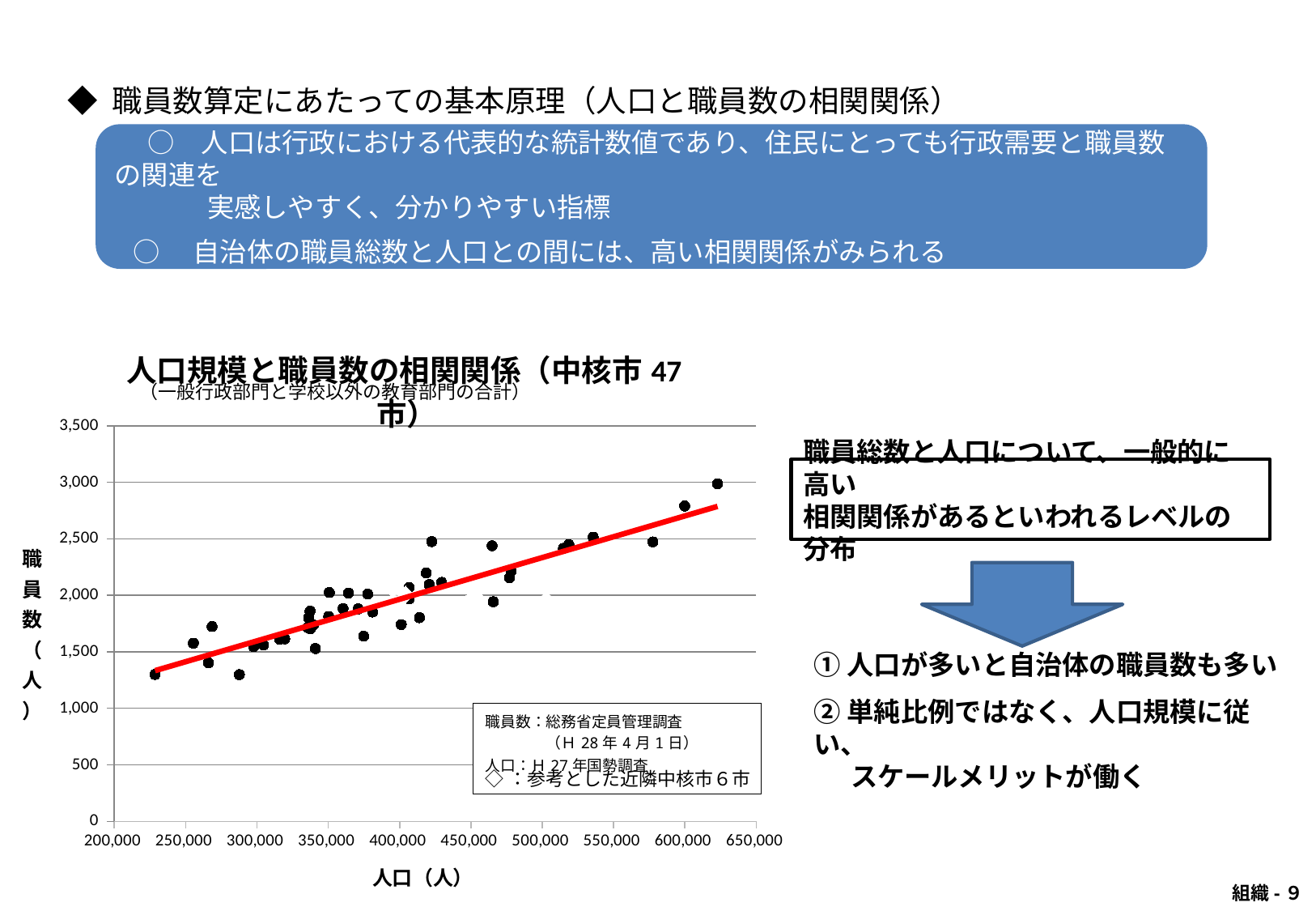
According to the chart title, how many core cities (中核市) are plotted? 47 What is the highest value shown on the y axis? 3,500 Are all plotted points below 3,500 on the y axis? yes What is the label of the x axis? 人口（人） What is the lowest value shown on the x axis? 200,000 Is the staff number for the point at roughly 600,000 population greater or less than 2,500? greater Is the staff number for the city with the smallest population (around 230,000) greater or less than 1,500? less What kind of chart is shown on the slide? scatter chart Do the plotted staff numbers generally rise or fall as population increases along the x axis? rise